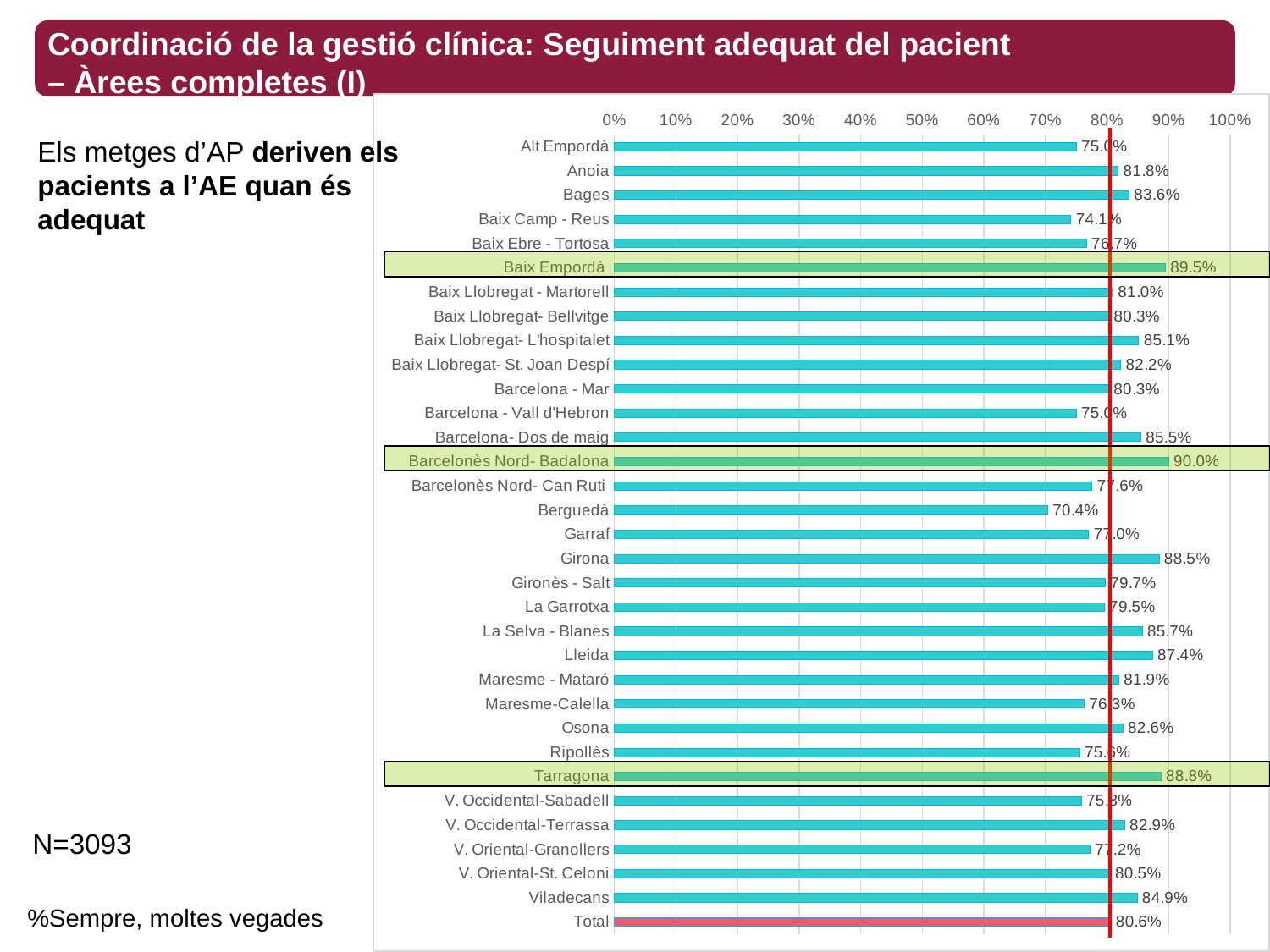
What is the difference between Barcelonès Nord- Badalona and Berguedà? 19.6% What kind of chart is shown on the slide? bar chart What is the value for Berguedà? 70.4% What is the difference between Tarragona and Girona? 0.3% Is the value for Baix Camp - Reus greater or less than 80%? less What is the value for Lleida? 87.4% Which area has the highest value? Barcelonès Nord- Badalona What is the value for Baix Empordà? 89.5% What is the value shown for Total? 80.6% How many bars are plotted in the chart, including Total? 33 Which is larger, the value for Bages or the value for Anoia? Bages Which area has the lowest value? Berguedà